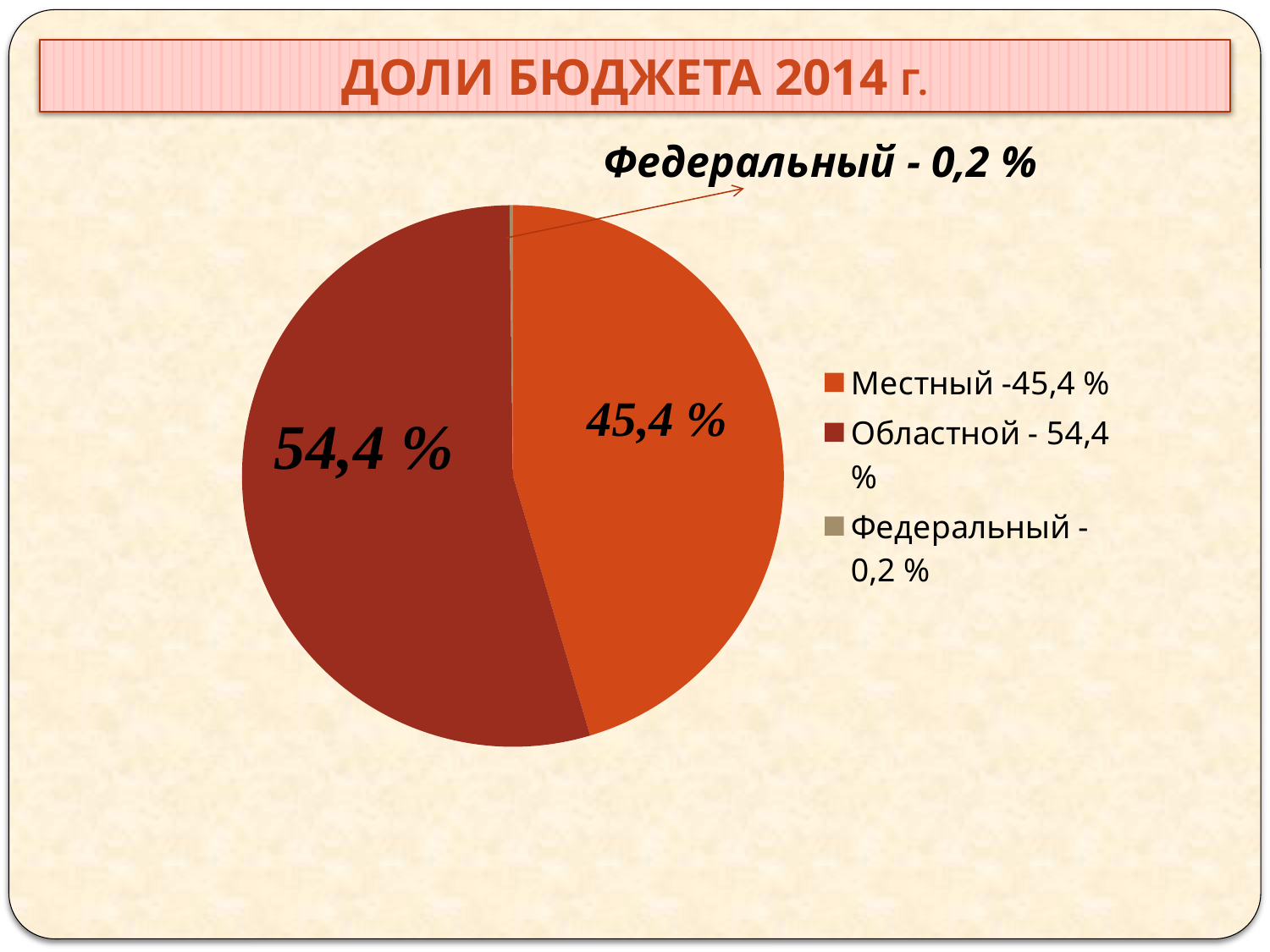
What is the share of the Федеральный slice in the pie chart? 0,2 % Which is larger, the Местный share or the Областной share? Областной How many entries does the legend of the pie chart list? 3 What is the title of the slide containing the pie chart? ДОЛИ БЮДЖЕТА 2014 г. What is the share of the Местный slice in the pie chart? 45,4 % What is the share of the Областной slice in the pie chart? 54,4 % By how many percentage points does the Областной share exceed the Местный share? 9 % What kind of chart is shown on the slide? pie chart How many slices does the pie chart have? 3 What colour is the Областной slice in the pie chart? dark red Which slice of the pie chart is the largest? Областной Which slice of the pie chart is the smallest? Федеральный